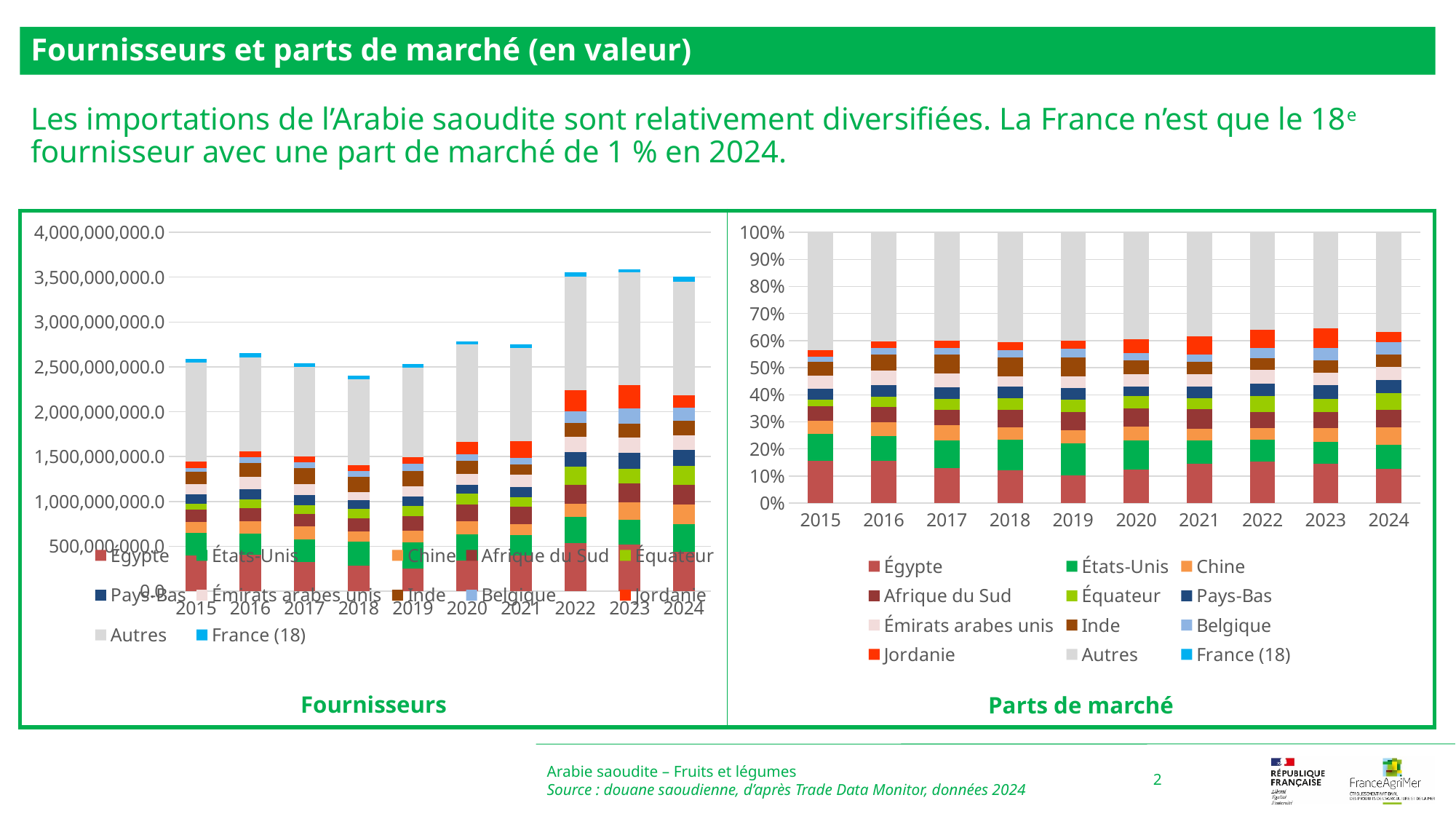
In the 'Fournisseurs' chart, is the total bar for 2022 greater or less than 3,000,000,000.0? greater In the 'Parts de marché' chart, is the share of Égypte in 2015 greater or less than 10%? greater In the 'Fournisseurs' chart, which total bar is larger, 2022 or 2018? 2022 In the 'Fournisseurs' chart, is the total bar for 2018 greater or less than 2,500,000,000.0? less What kind of chart is the 'Fournisseurs' chart on the left? Stacked bar chart What is the title of the chart on the right of the slide? Parts de marché In the 'Fournisseurs' chart, is the total bar for 2024 higher or lower than the total bar for 2015? higher Which series is listed last in the legend of the 'Parts de marché' chart? France (18) How many years are shown on the x axis of the 'Parts de marché' chart? 10 How many series does the legend of the 'Parts de marché' chart list? 12 In the 'Fournisseurs' chart, which year has the lowest total bar? 2018